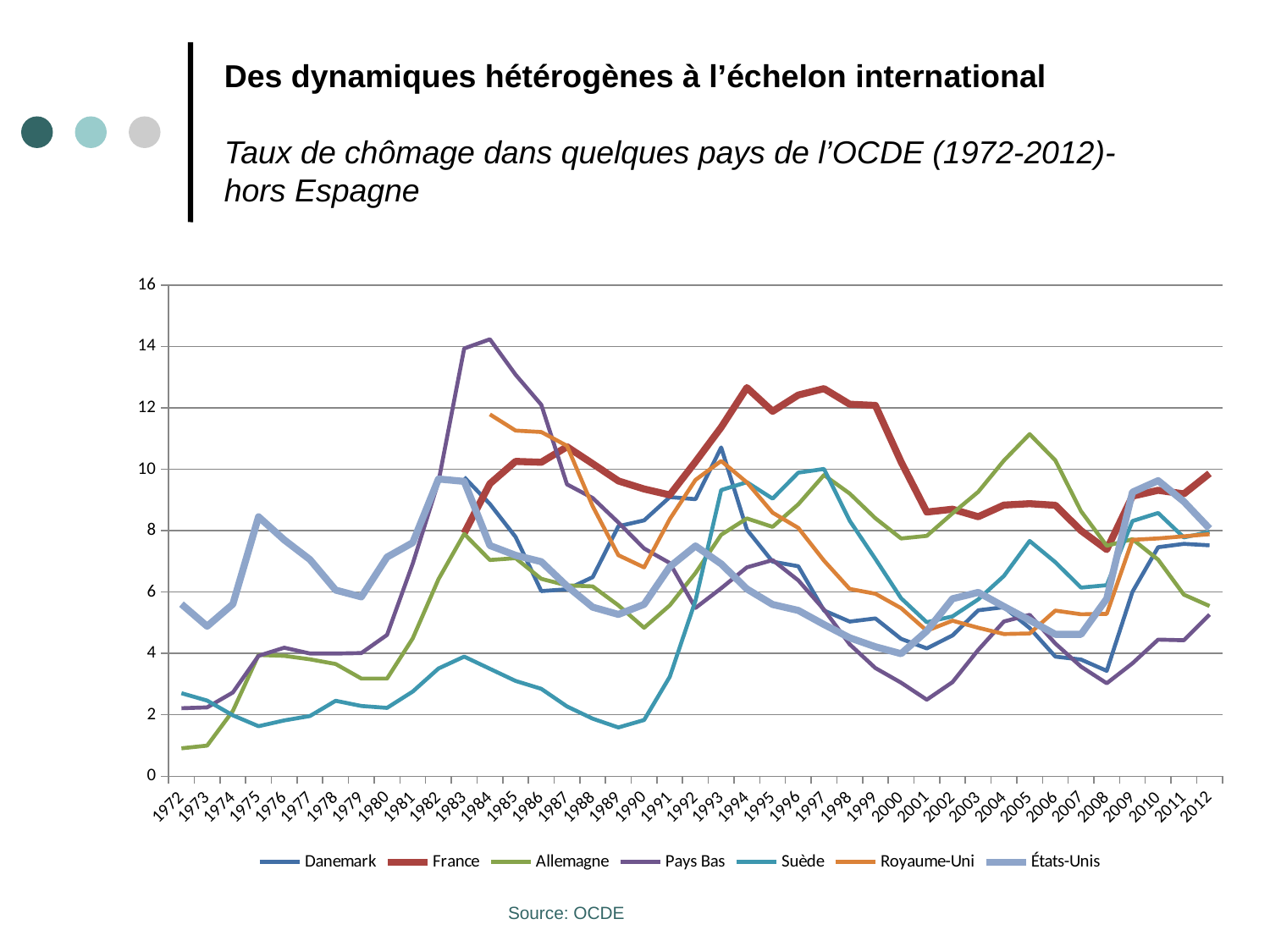
Which country has the lowest value anywhere on the chart? Allemagne In 1997, which is larger, the value for Suède or the value for Pays Bas? Suède Which country reaches the highest unemployment rate anywhere on the chart? Pays Bas Is the value for Suède in 1989 greater or less than 2? less What kind of chart is shown on the slide? line chart How many series does the legend list? 7 Is the value for Danemark in 2008 greater or less than 4? less Is the value for France in 1994 greater or less than 12? greater How many years are shown along the x axis? 41 What source is cited below the chart? OCDE In 2012, which is larger, the value for France or the value for Allemagne? France